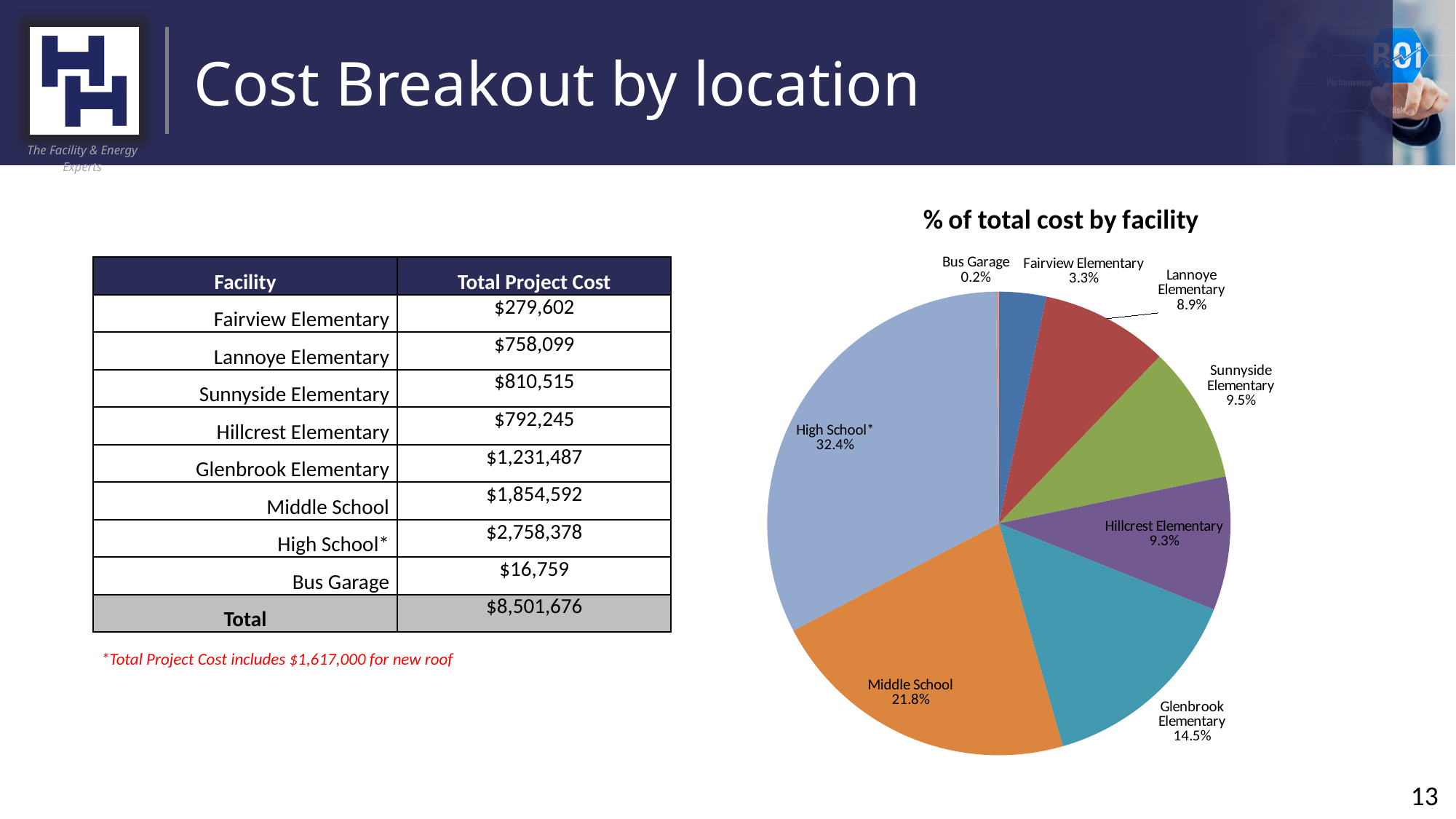
What type of chart is shown on the slide? pie chart Which has a larger share of total cost, Sunnyside Elementary or Lannoye Elementary? Sunnyside Elementary What share of total cost does the High School* slice represent? 32.4% What is the difference in percentage points between the High School* and Middle School slices? 10.6 What is the percentage shown for Hillcrest Elementary in the pie chart? 9.3% Which facility has the smallest share of total cost in the pie chart? Bus Garage What percentage of total cost is attributed to Middle School in the pie chart? 21.8% How many slices does the pie chart have? 8 What is the title of the pie chart? % of total cost by facility Which facility has the largest share of total cost in the pie chart? High School* What is the percentage shown for Fairview Elementary in the pie chart? 3.3% What is the percentage shown for Glenbrook Elementary in the pie chart? 14.5%